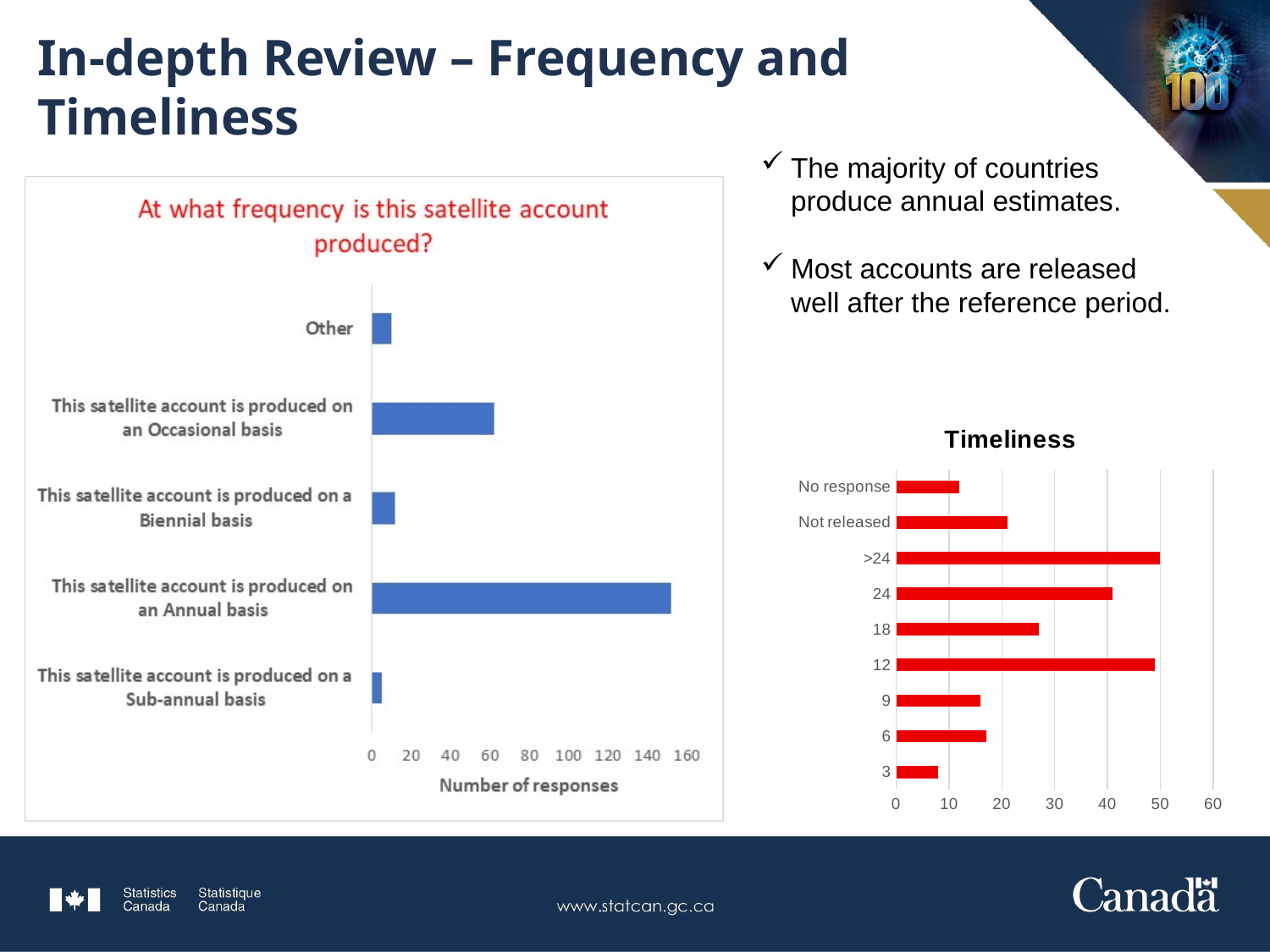
How many categories are shown in the chart titled 'At what frequency is this satellite account produced?'? 5 In the chart titled 'At what frequency is this satellite account produced?', is the value for the Annual basis greater or less than 140? greater In the chart titled 'At what frequency is this satellite account produced?', is the value for the Occasional basis greater or less than 40? greater In the Timeliness chart, which is larger, the value for '24' or the value for '9'? 24 In the Timeliness chart, is the value for '18' greater or less than 30? less In the chart titled 'At what frequency is this satellite account produced?', which category has the highest number of responses? This satellite account is produced on an Annual basis In the Timeliness chart, which category has the lowest value? 3 What type of chart is the chart titled 'At what frequency is this satellite account produced?'? bar chart What is the x-axis label of the chart titled 'At what frequency is this satellite account produced?'? Number of responses In the chart titled 'At what frequency is this satellite account produced?', which category has the lowest number of responses? This satellite account is produced on a Sub-annual basis How many categories are shown in the Timeliness chart? 9